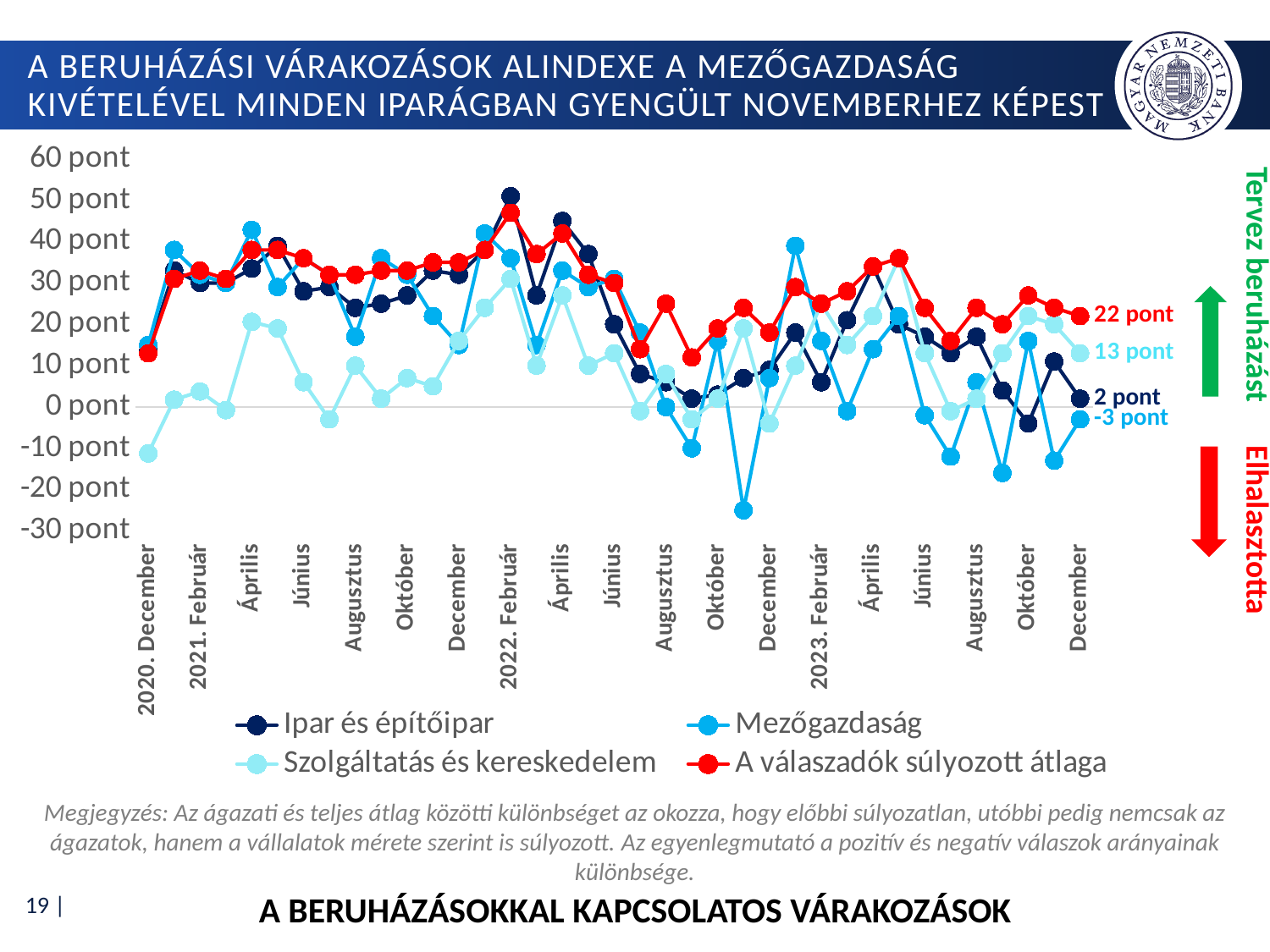
In December 2023, which is larger: the value for Ipar és építőipar or the value for Mezőgazdaság? Ipar és építőipar Which series has the lowest value in December 2023? Mezőgazdaság What kind of chart is shown on the slide? line chart Is the value for Mezőgazdaság in 2020. December greater or less than 0 pont? greater What is the difference between the December 2023 values of A válaszadók súlyozott átlaga and Szolgáltatás és kereskedelem? 9 pont What is the value for Mezőgazdaság at the end of the series (December 2023)? -3 pont How many series does the legend list? 4 What is the value for Szolgáltatás és kereskedelem at the end of the series (December 2023)? 13 pont Which series has the highest value in December 2023? A válaszadók súlyozott átlaga What is the value for A válaszadók súlyozott átlaga at the end of the series (December 2023)? 22 pont Is the value for Ipar és építőipar in 2022. Február greater or less than 40 pont? greater What is the value for Ipar és építőipar at the end of the series (December 2023)? 2 pont